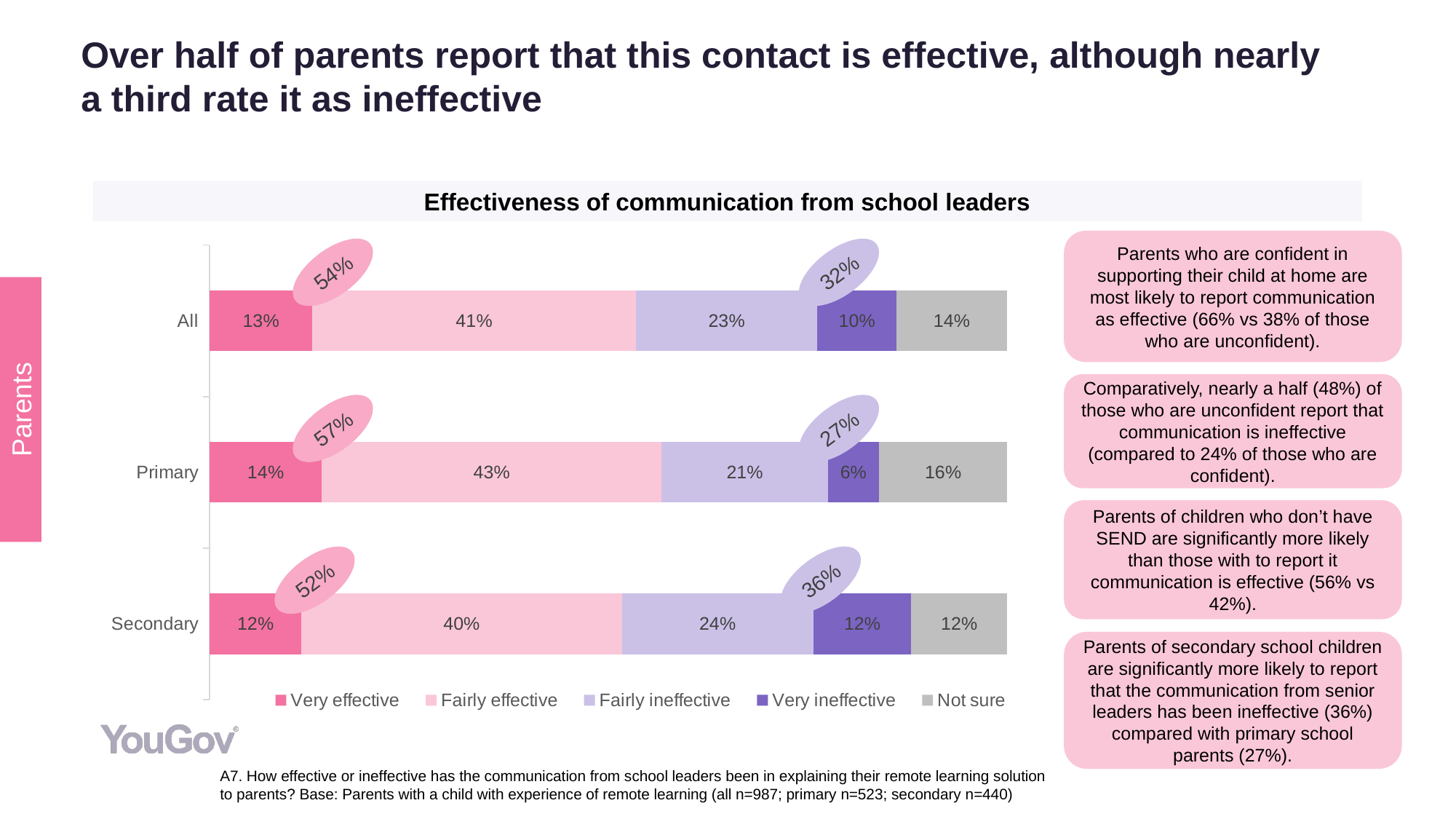
How many series does the legend list? 5 What is the title of the chart? Effectiveness of communication from school leaders How many groups (categories) are shown on the chart? 3 What is the difference between the 'Fairly ineffective' percentages for Secondary and Primary parents? 3 percentage points What kind of chart is shown on the slide? Stacked bar chart What is the combined 'Very effective' and 'Fairly effective' percentage for Secondary parents, as shown in the callout? 52% What percentage of primary school parents answered 'Not sure'? 16% Which group has the lowest 'Very ineffective' percentage? Primary What percentage of all parents rated communication from school leaders as 'Fairly effective'? 41% Which group has the highest 'Fairly effective' percentage? Primary Is the 'Very effective' percentage larger for Primary or Secondary parents? Primary What percentage of secondary school parents said 'Very ineffective'? 12%